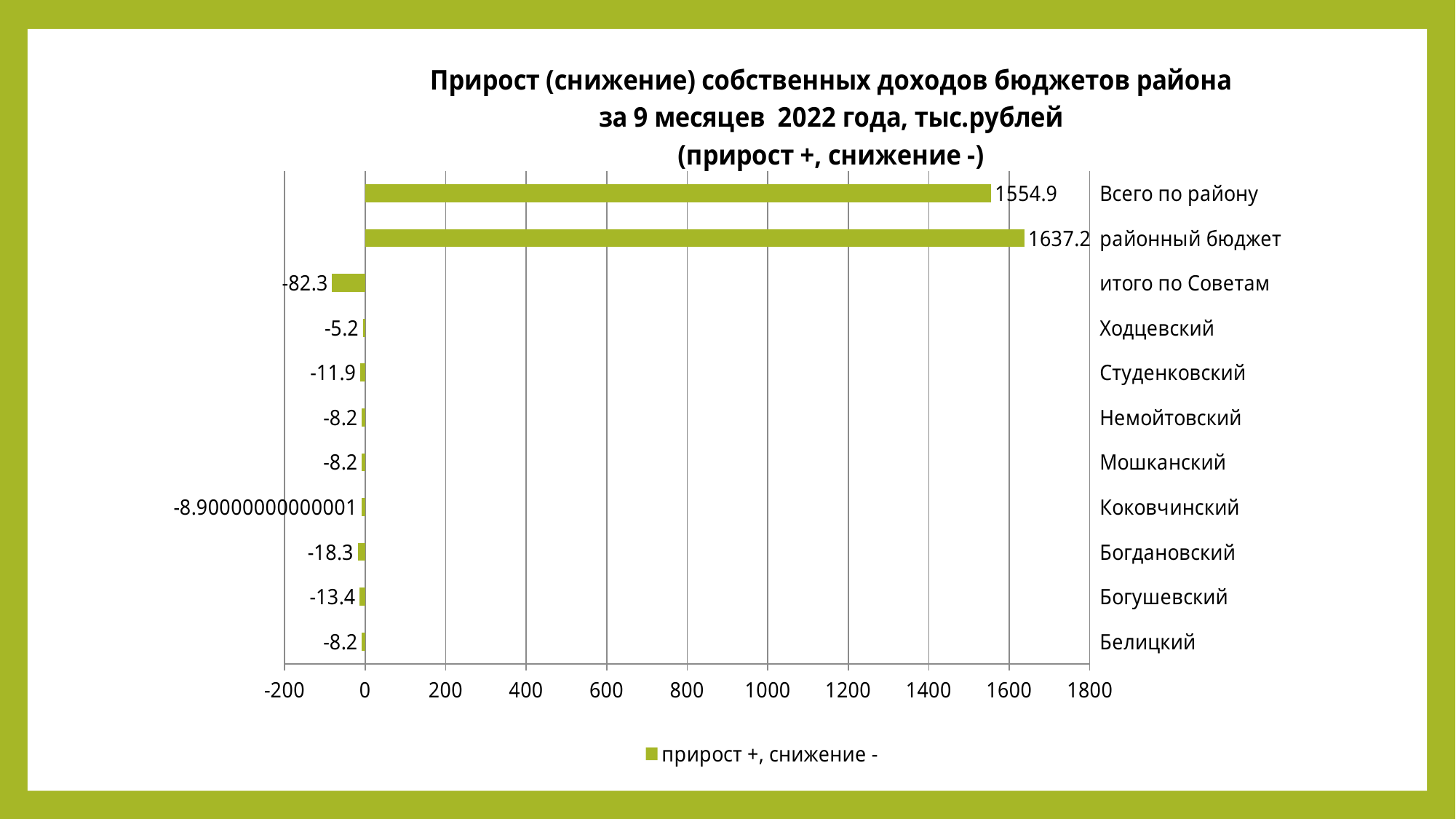
What kind of chart is shown on the slide? Bar chart Which is larger, the value for Богушевский or the value for Ходцевский? Ходцевский What is the value for Богдановский? -18.3 What is the legend entry shown below the chart? прирост +, снижение - What is the difference between the values for районный бюджет and Всего по району? 82.3 Which category has the lowest value? итого по Советам What is the value for районный бюджет? 1637.2 How many categories are shown on the chart? 11 What is the value for Всего по району? 1554.9 What is the value for итого по Советам? -82.3 Which category has the highest value? районный бюджет What is the value for Студенковский? -11.9